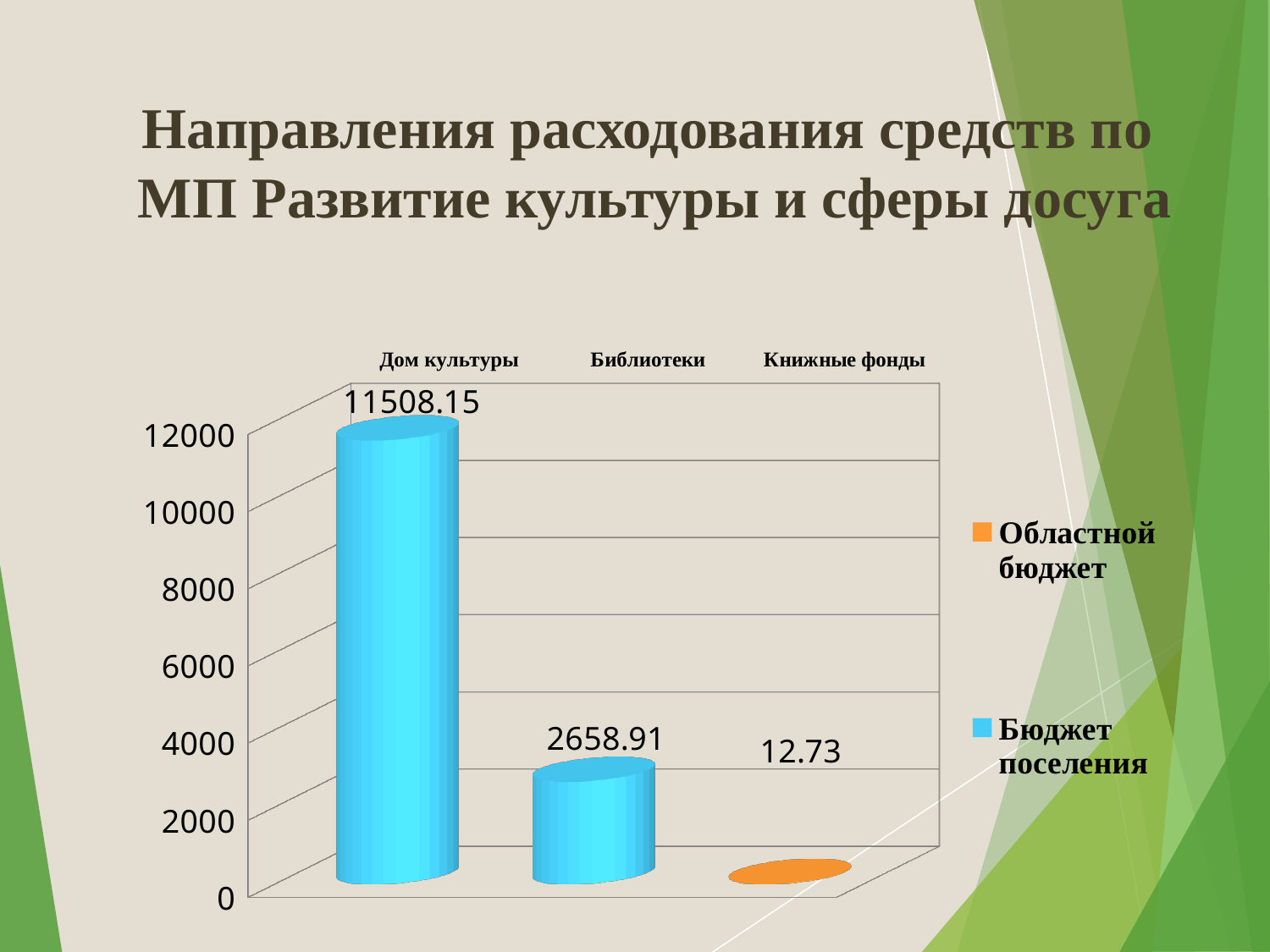
What is the value shown for Библиотеки? 2658.91 Which category has the highest value? Дом культуры What kind of chart is shown on the slide? bar chart What is the value shown for Дом культуры? 11508.15 Which legend series is shown in orange? Областной бюджет What is the value shown for Книжные фонды? 12.73 What is the difference between the values for Дом культуры and Библиотеки? 8849.24 Which is larger, the value for Библиотеки or the value for Книжные фонды? Библиотеки How many series does the legend list? 2 How many categories are shown on the chart? 3 Is the value for Библиотеки greater or less than 4000? less Which category has the lowest value? Книжные фонды